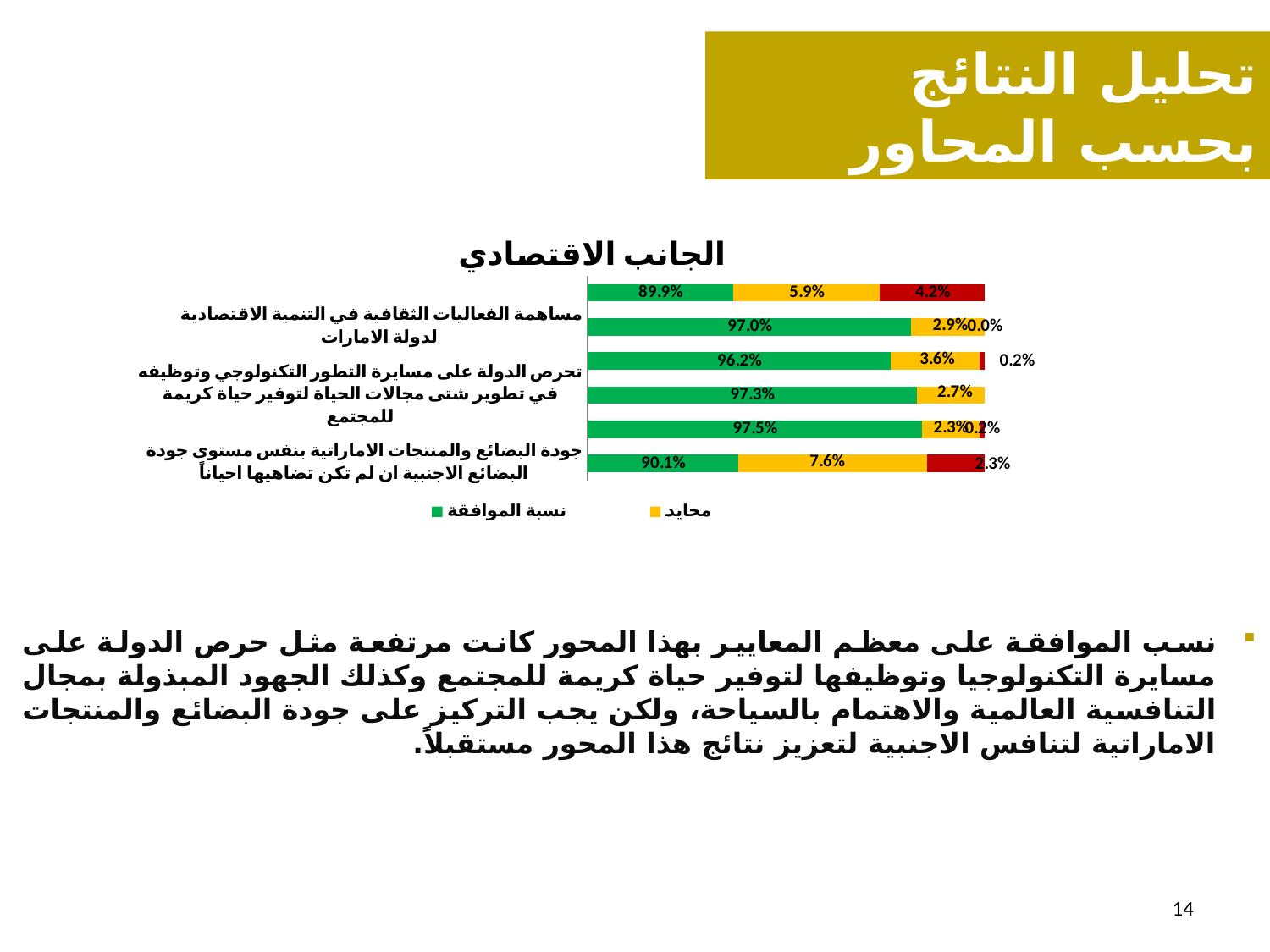
What is the محايد (neutral) value for the category جودة البضائع والمنتجات الاماراتية بنفس مستوى جودة البضائع الاجنبية? 7.6% What is the highest نسبة الموافقة (agreement) value shown in the chart? 97.5% What is the نسبة الموافقة value for the category مساهمة الفعاليات الثقافية في التنمية الاقتصادية لدولة الامارات? 97.0% What kind of chart is shown under the title الجانب الاقتصادي? Stacked horizontal bar chart What is the title of the chart on the slide? الجانب الاقتصادي What is the difference between the highest and lowest نسبة الموافقة values in the chart? 7.6 percentage points What is the نسبة الموافقة value for the category حرص الدولة على مسايرة التطور التكنولوجي وتوظيفه في تطوير شتى مجالات الحياة? 97.3% What is the lowest نسبة الموافقة (agreement) value shown in the chart? 89.9% Which has a larger محايد value: جودة البضائع والمنتجات الاماراتية or مساهمة الفعاليات الثقافية في التنمية الاقتصادية? جودة البضائع والمنتجات الاماراتية What is the نسبة الموافقة value for the category جودة البضائع والمنتجات الاماراتية بنفس مستوى جودة البضائع الاجنبية? 90.1% What colour represents نسبة الموافقة in the chart legend? Green How many bars does the chart الجانب الاقتصادي contain? 6